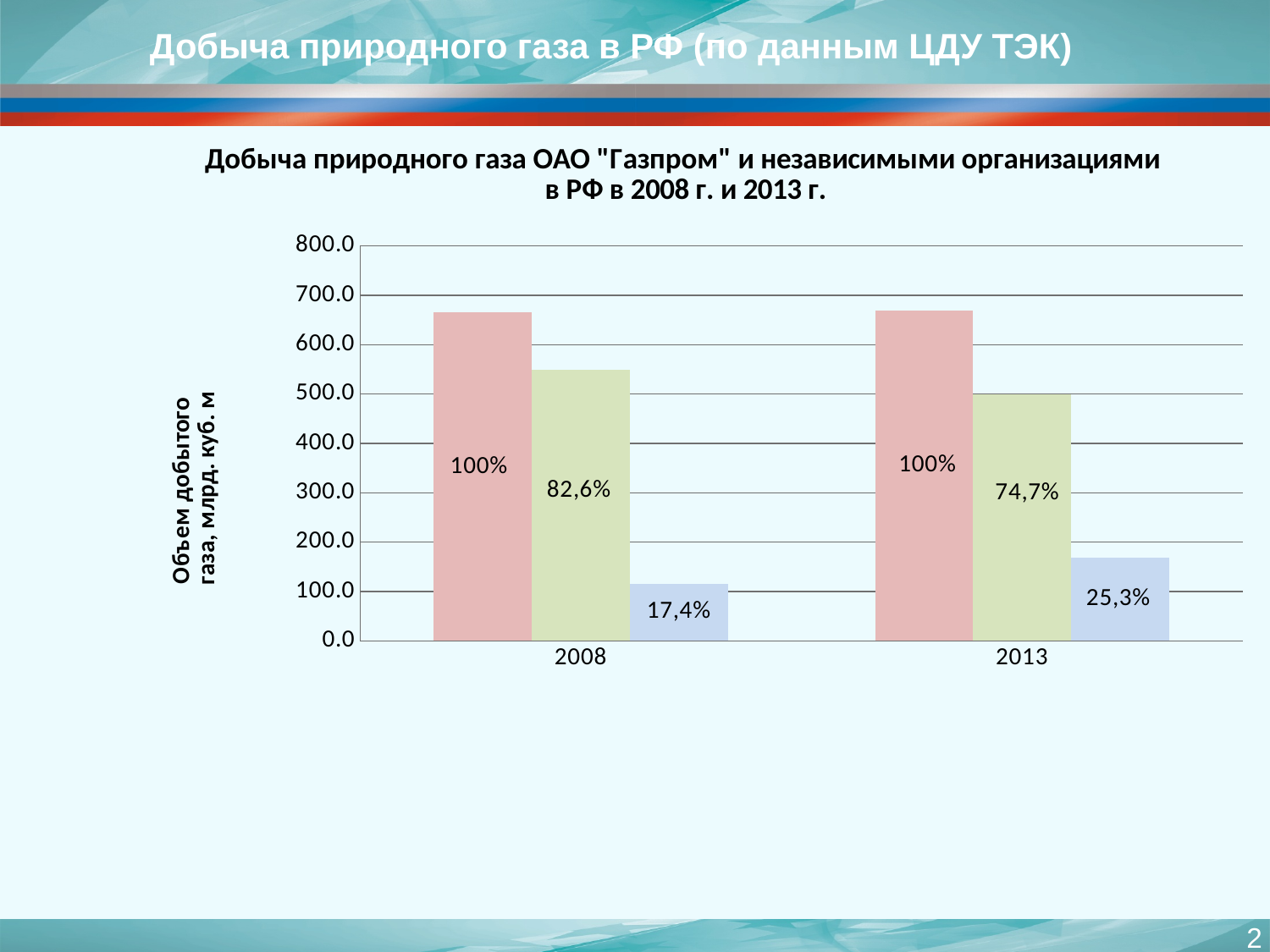
What percentage label is printed on the blue bar for 2013? 25,3% Is the value of the blue bar for 2013 greater or less than 200.0? less What kind of chart is shown on the slide? bar chart What percentage label is printed on the green bar for 2013? 74,7% Does the green bar rise or fall from 2008 to 2013? fall Is the value of the pink bar for 2013 greater or less than 600.0? greater Is the value of the green bar for 2008 greater or less than 500.0? greater What percentage label is printed on the blue bar for 2008? 17,4% What percentage label is printed on the green bar for 2008? 82,6% Which is larger: the blue bar for 2008 or the blue bar for 2013? 2013 What is the label of the vertical axis? Объем добытого газа, млрд. куб. м How many year categories are shown on the x axis? 2